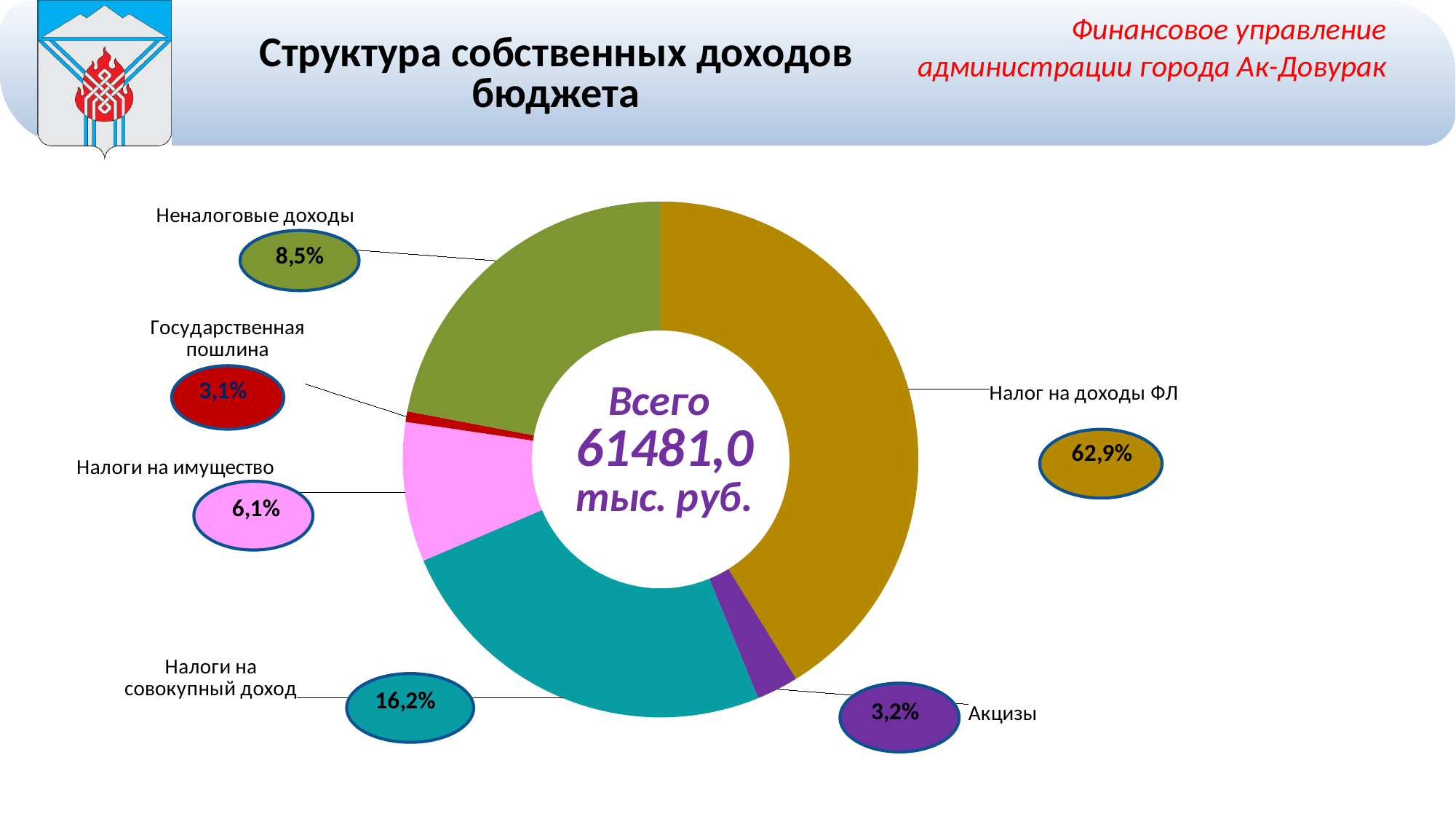
What colour is the slice for Налоги на совокупный доход? Teal What type of chart is shown on the slide? Pie chart (donut) How many categories does the chart show? 6 Which is larger: the share of Неналоговые доходы or the share of Налоги на имущество? Неналоговые доходы What share is shown for Неналоговые доходы? 8,5% What total amount is shown in the centre of the chart? 61481,0 тыс. руб. Which category has the largest share of own budget revenues? Налог на доходы ФЛ Which category has the smallest share of own budget revenues? Государственная пошлина What share is shown for Акцизы? 3,2% What is the difference in percentage points between Налог на доходы ФЛ and Налоги на совокупный доход? 46,7 What share of own budget revenues comes from Налог на доходы ФЛ? 62,9% What share is shown for Налоги на совокупный доход? 16,2%